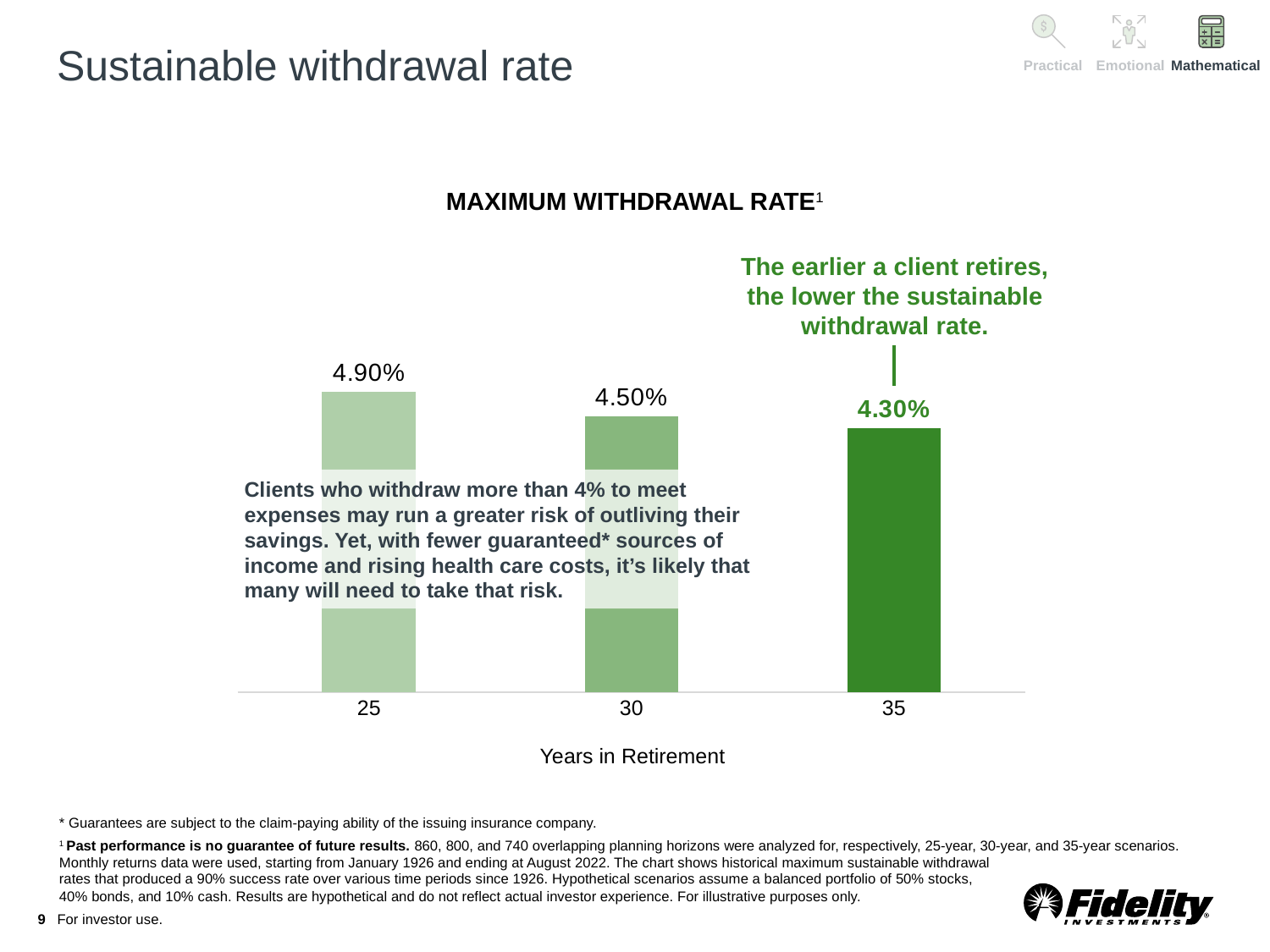
What is the maximum withdrawal rate for 25 years in retirement? 4.90% How many categories (years in retirement) are shown on the chart? 3 Which is larger, the maximum withdrawal rate for 30 years or for 35 years in retirement? 30 years What kind of chart is shown on the slide? Bar chart What is the difference between the maximum withdrawal rate for 25 years and for 35 years in retirement? 0.60% What is the label of the x axis of the chart? Years in Retirement What is the difference between the maximum withdrawal rate for 25 years and for 30 years in retirement? 0.40% Do the maximum withdrawal rates rise or fall as years in retirement increase? Fall Which number of years in retirement has the lowest maximum withdrawal rate? 35 What is the maximum withdrawal rate for 35 years in retirement? 4.30% What is the maximum withdrawal rate for 30 years in retirement? 4.50% Which number of years in retirement has the highest maximum withdrawal rate? 25